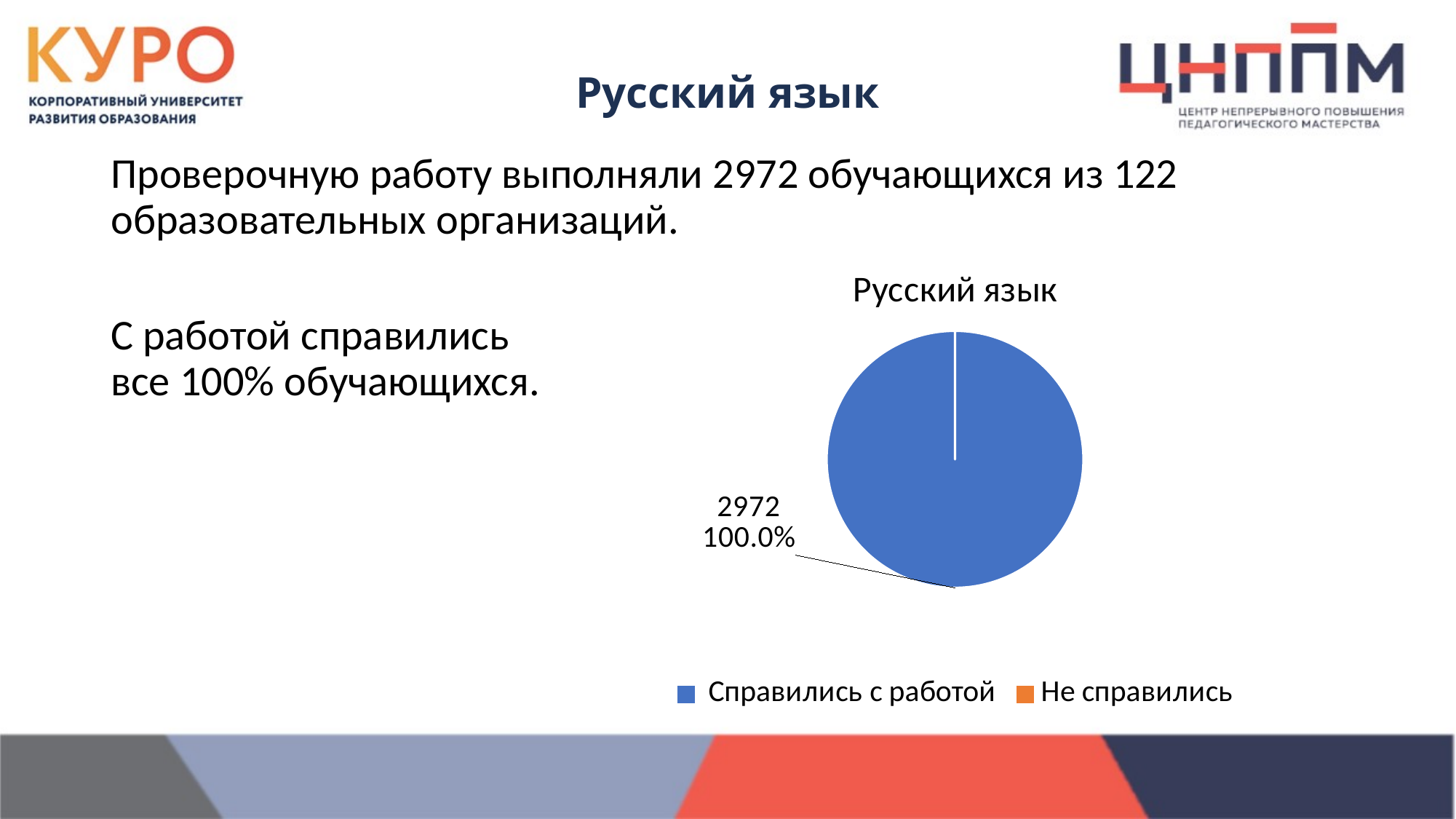
Which is larger, the share for 'Справились с работой' or the share for 'Не справились'? Справились с работой What colour is used for the 'Справились с работой' category in the legend? blue What value is printed on the data label of the 'Справились с работой' slice? 2972 How many slices are visibly drawn in the pie? 1 How many entries does the chart legend list? 2 Which category takes the largest share of the pie? Справились с работой What kind of chart is shown on the slide? pie chart What share of the pie does the 'Справились с работой' slice take? 100.0% What is the title of the chart? Русский язык Which category takes the smallest share of the pie? Не справились